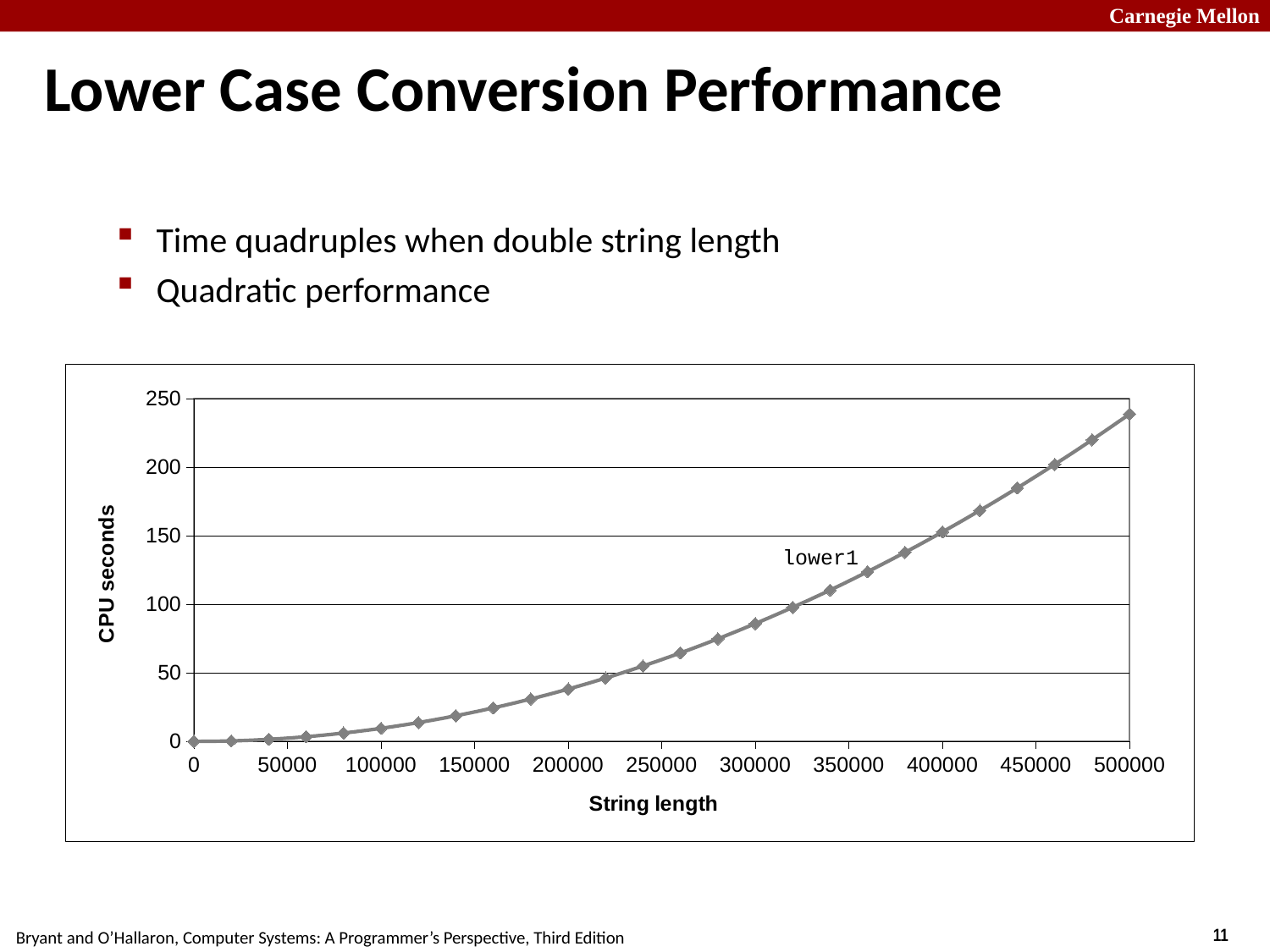
Which has the larger CPU seconds value: string length 100000 or string length 400000? 400000 At which string length is the CPU seconds value lowest? 0 What is the label of the plotted series in the chart? lower1 What kind of chart is shown on the slide? line chart Is the CPU seconds value at string length 500000 greater or less than 200? greater Do the CPU seconds values rise or fall as string length increases along the x axis? rise Is the CPU seconds value at string length 200000 greater or less than 50? less Is the CPU seconds value at string length 400000 greater or less than 100? greater At which string length is the CPU seconds value highest? 500000 What is the title of the y axis of the chart? CPU seconds How many series does the chart plot? 1